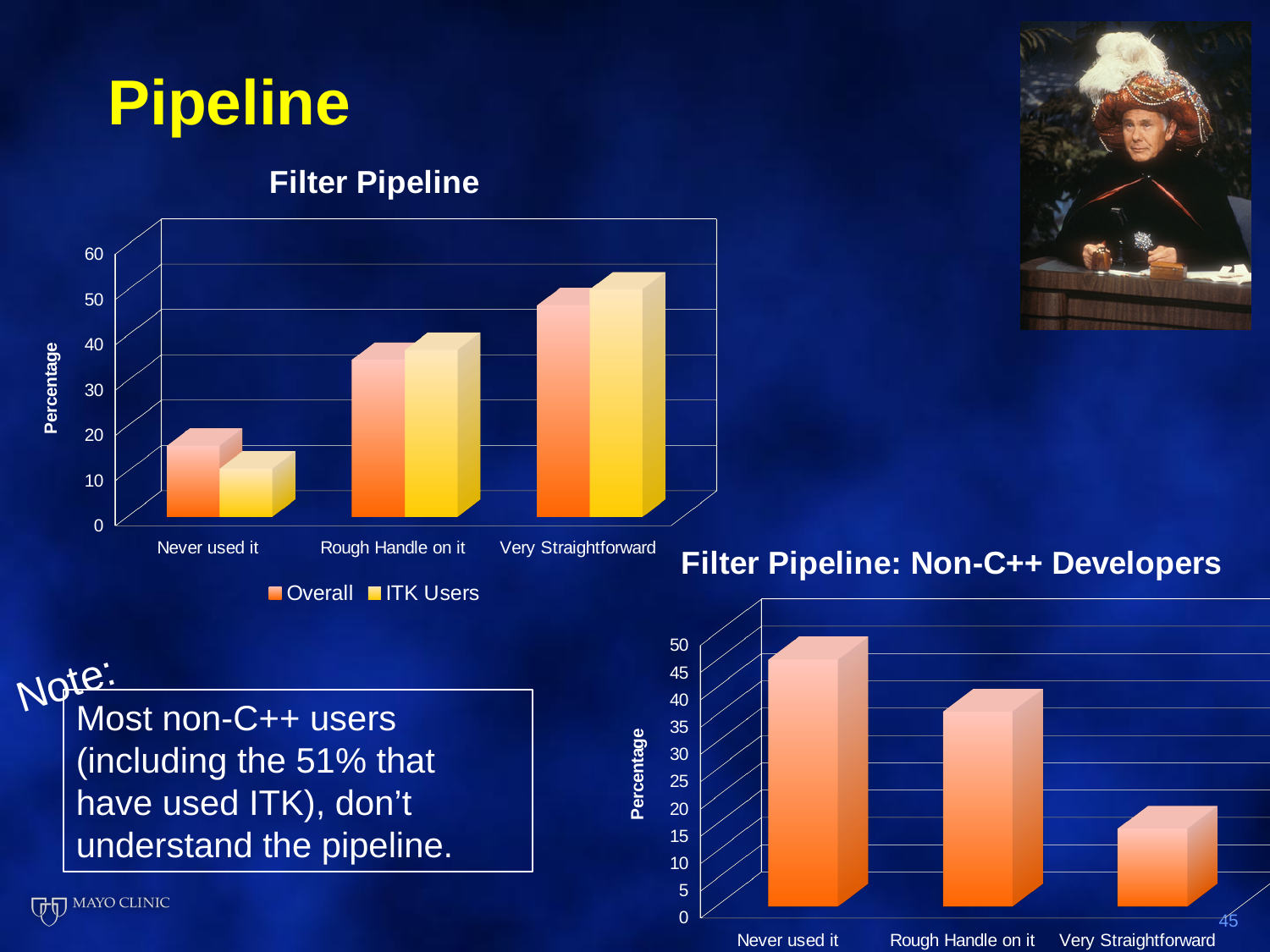
In the 'Filter Pipeline: Non-C++ Developers' chart, is the value for 'Rough Handle on it' greater or less than 25? greater In the 'Filter Pipeline' chart, how many series does the legend list? 2 In the 'Filter Pipeline' chart, is the ITK Users value for 'Very Straightforward' greater or less than 40? greater In the 'Filter Pipeline: Non-C++ Developers' chart, which category has the lowest value? Very Straightforward In the 'Filter Pipeline: Non-C++ Developers' chart, which category has the highest value? Never used it In the 'Filter Pipeline' chart, which category has the highest value for the Overall series? Very Straightforward In the 'Filter Pipeline' chart, how many categories are shown on the x axis? 3 In the 'Filter Pipeline' chart, do the Overall values rise or fall from 'Never used it' to 'Very Straightforward'? rise In the 'Filter Pipeline' chart, what kind of chart is shown? bar chart In the 'Filter Pipeline: Non-C++ Developers' chart, what is the label of the vertical axis? Percentage In the 'Filter Pipeline' chart, which category has the lowest value for the ITK Users series? Never used it In the 'Filter Pipeline' chart, is the Overall value for 'Never used it' greater or less than 30? less